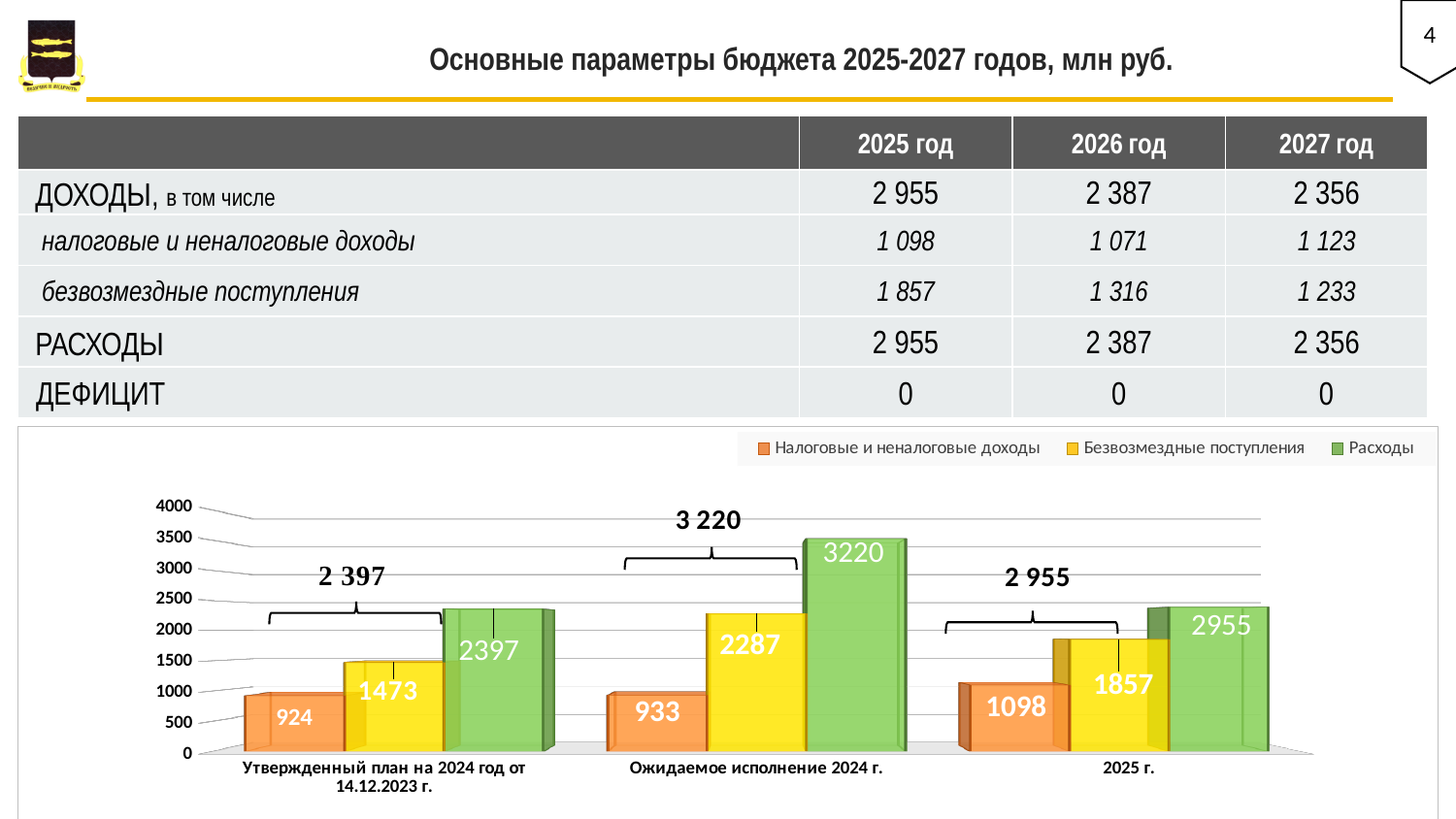
What is the value of Безвозмездные поступления for Утвержденный план на 2024 год от 14.12.2023 г.? 1473 What kind of chart is shown on the slide? bar chart Which category has the highest value for Расходы? Ожидаемое исполнение 2024 г. What is the value of Налоговые и неналоговые доходы for 2025 г.? 1098 Which is larger: Расходы for Утвержденный план на 2024 год от 14.12.2023 г. or Расходы for 2025 г.? Расходы for 2025 г. How many series does the chart legend list? 3 Which series in the chart legend is shown in green? Расходы What is the difference between Безвозмездные поступления for Ожидаемое исполнение 2024 г. and for 2025 г.? 430 Which category has the lowest value for Налоговые и неналоговые доходы? Утвержденный план на 2024 год от 14.12.2023 г. How many categories are shown on the x axis of the chart? 3 Is the value of Безвозмездные поступления for 2025 г. greater or less than 2000? less What is the value of Расходы for Ожидаемое исполнение 2024 г.? 3220